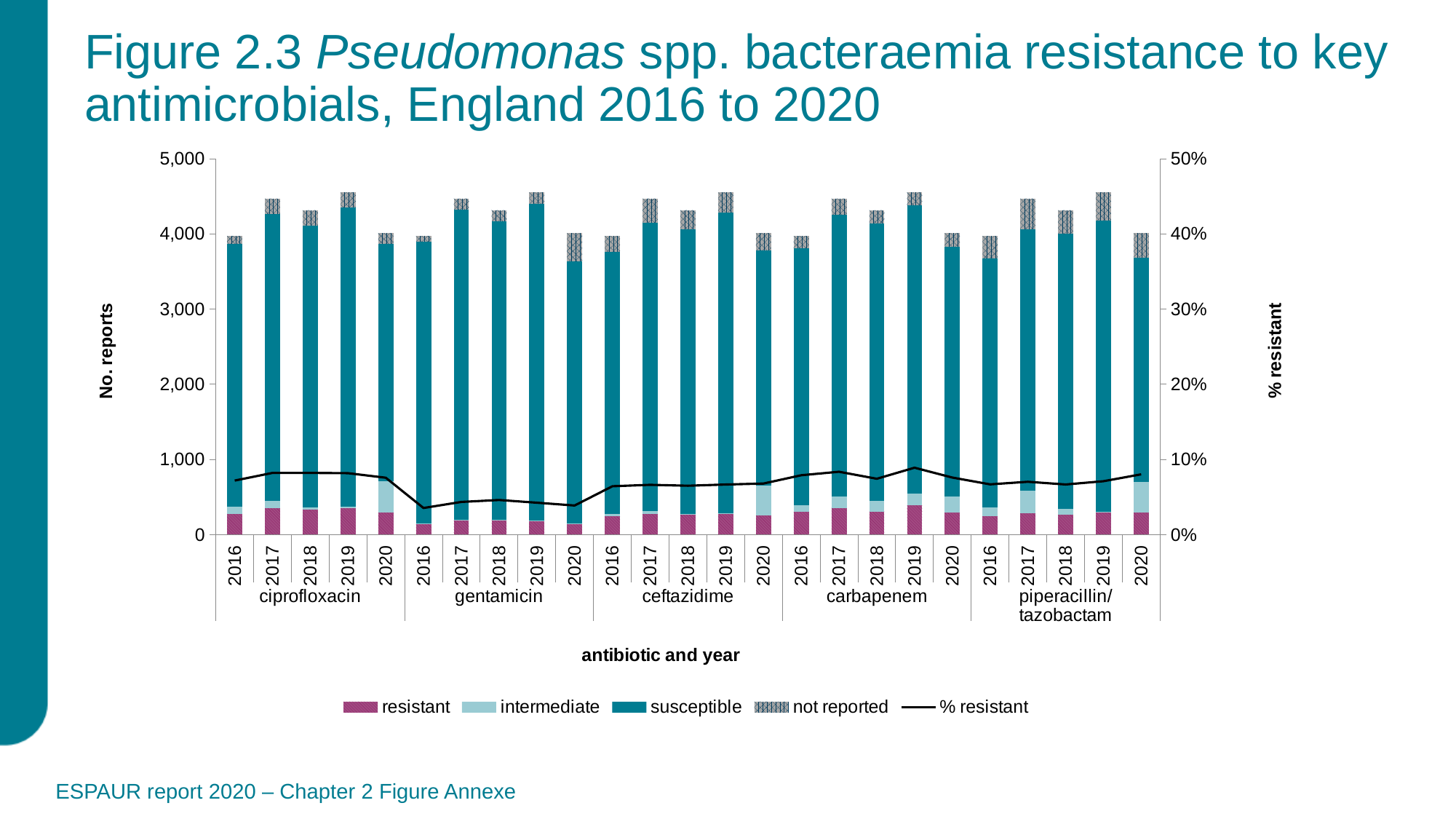
How many antibiotic groups are shown along the x axis? 5 What kind of chart is shown on the slide? A stacked bar chart with a line overlay What is the label of the right vertical axis? % resistant Is the % resistant value for carbapenem in 2019 greater or less than 10%? less Which antibiotic has the lowest % resistant line across all years? gentamicin Is the % resistant value for gentamicin in 2016 higher or lower than for ciprofloxacin in 2016? lower What is the label of the left vertical axis? No. reports How many entries does the legend list? 5 How many bars are plotted in total on the chart? 25 Is the total number of reports for ciprofloxacin in 2019 greater or less than 4,000? greater Is the % resistant value for ciprofloxacin in 2017 greater or less than 5%? greater